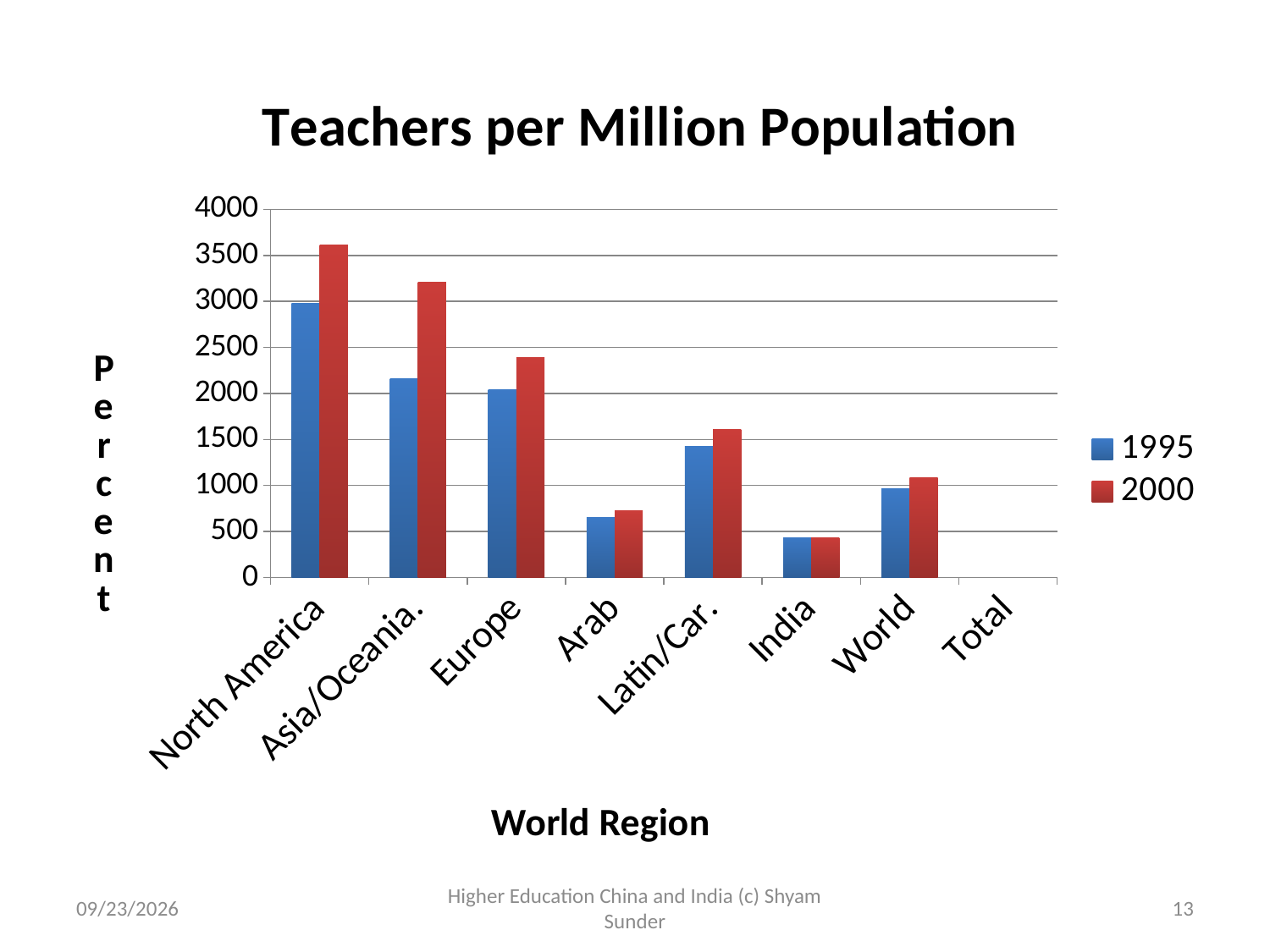
What kind of chart is shown on the slide? bar chart Is the 1995 value for Arab greater or less than 500? greater Among the regions with plotted bars, which has the lowest value for 1995? India Is the 2000 value for India greater or less than 500? less Which region has the highest value for 2000? North America How many series does the legend list? 2 Which region has the highest value for 1995? North America Is the 2000 value for North America greater or less than 3500? greater Which is larger for 2000: Arab or Latin/Car.? Latin/Car. What is the title of the chart? Teachers per Million Population How many categories are labelled on the x axis? 8 Which is larger for 2000: Asia/Oceania. or Europe? Asia/Oceania.